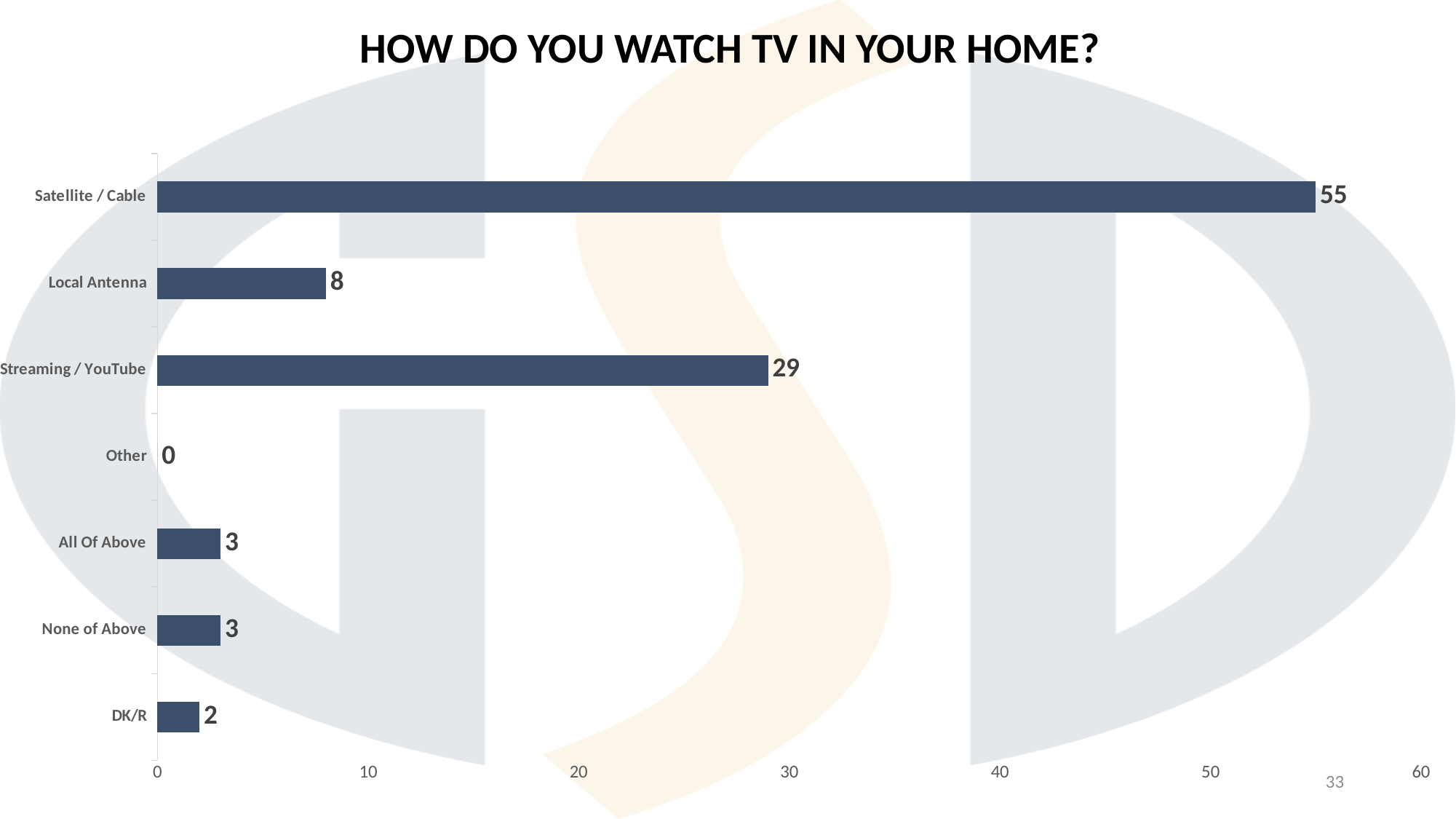
Which is larger, the value for Local Antenna or the value for All Of Above? Local Antenna Is the value for Satellite / Cable greater or less than 50? greater Which category has the highest value? Satellite / Cable What is the value for Local Antenna? 8 What is the difference between the values for Satellite / Cable and Streaming / YouTube? 26 What is the title of the chart? HOW DO YOU WATCH TV IN YOUR HOME? What is the value for Streaming / YouTube? 29 What kind of chart is shown on the slide? bar chart Which category has the lowest value? Other What is the value for Satellite / Cable? 55 How many categories are shown in the chart? 7 What is the value for DK/R? 2